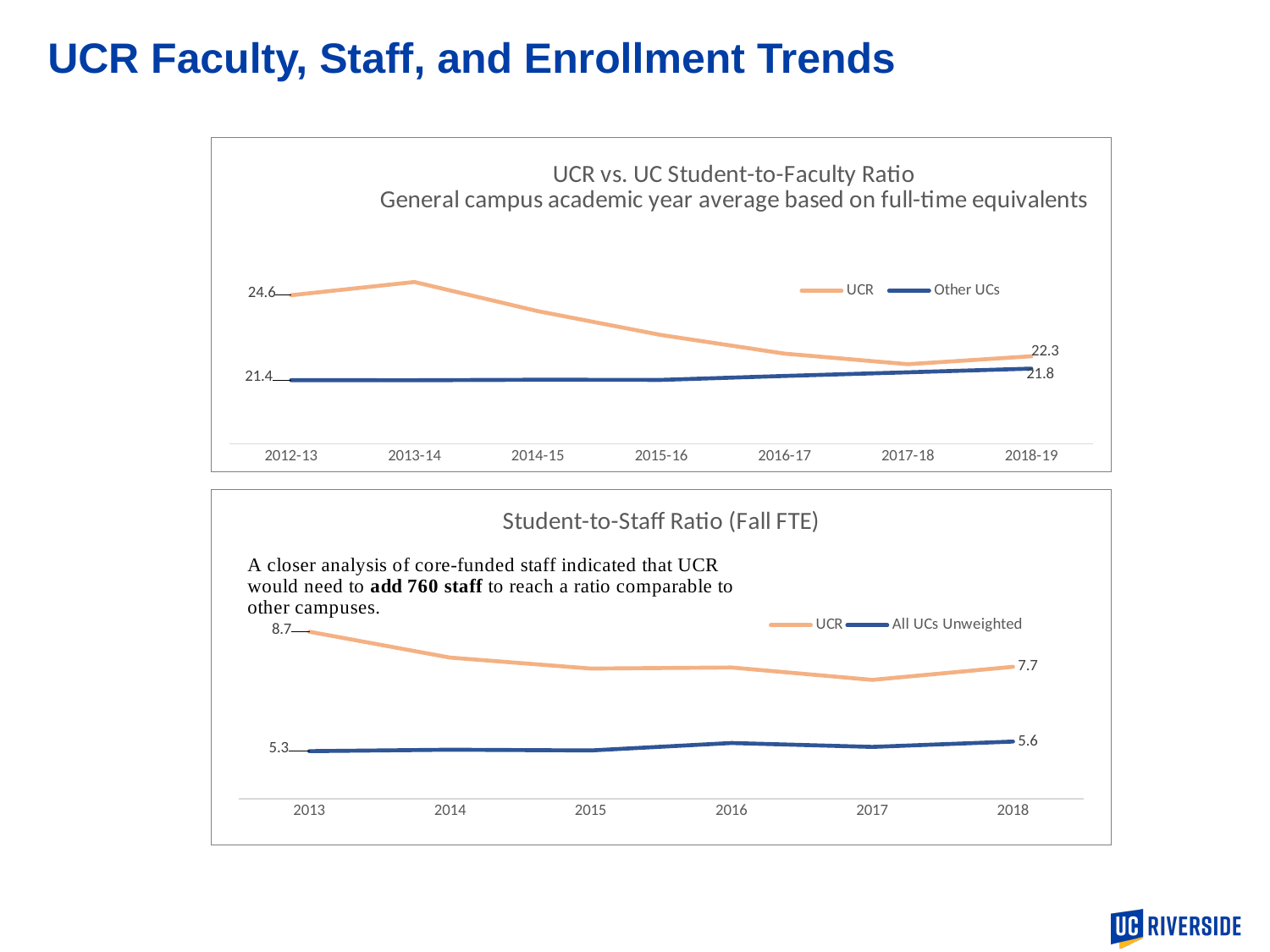
In the top chart (UCR vs. UC Student-to-Faculty Ratio), what is the UCR value for 2012-13? 24.6 In the top chart (UCR vs. UC Student-to-Faculty Ratio), how many academic years are shown on the x axis? 7 What type of chart is the bottom chart (Student-to-Staff Ratio)? line chart In the bottom chart (Student-to-Staff Ratio), what is the All UCs Unweighted value for 2018? 5.6 In the bottom chart (Student-to-Staff Ratio), what is the UCR value for 2013? 8.7 In the top chart (UCR vs. UC Student-to-Faculty Ratio), by how much did the UCR ratio fall from 2012-13 to 2018-19? 2.3 In the top chart (UCR vs. UC Student-to-Faculty Ratio), what is the Other UCs value for 2018-19? 21.8 In the bottom chart (Student-to-Staff Ratio), what is the difference between the UCR and All UCs Unweighted values in 2018? 2.1 In the bottom chart (Student-to-Staff Ratio), how many series does the legend list? 2 In the top chart (UCR vs. UC Student-to-Faculty Ratio), which series is higher in 2012-13, UCR or Other UCs? UCR In the top chart (UCR vs. UC Student-to-Faculty Ratio), what is the UCR value for 2018-19? 22.3 In the top chart (UCR vs. UC Student-to-Faculty Ratio), does the UCR line generally rise or fall from 2013-14 to 2017-18? fall